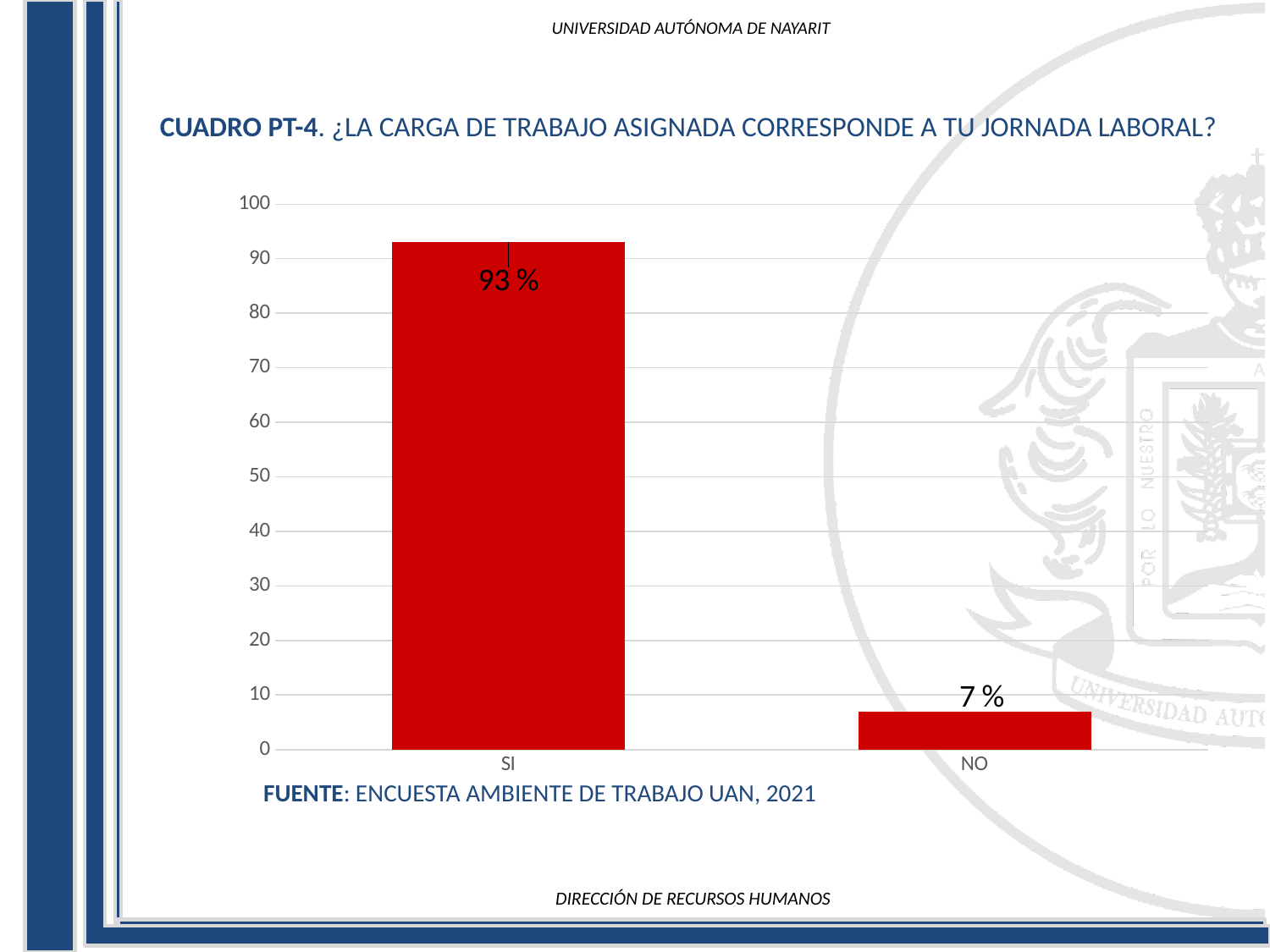
What is the source cited below the chart? ENCUESTA AMBIENTE DE TRABAJO UAN, 2021 Which category has the highest value? SI What is the value for SI? 93 % What kind of chart is shown on the slide? bar chart Is the value for SI greater or less than 90? greater How many categories are shown on the x axis? 2 What colour are the bars in the chart? red What is the difference between the values for SI and NO? 86 % What is the value for NO? 7 % Which category has the lowest value? NO Which is larger, the value for SI or the value for NO? SI Is the value for NO greater or less than 10? less